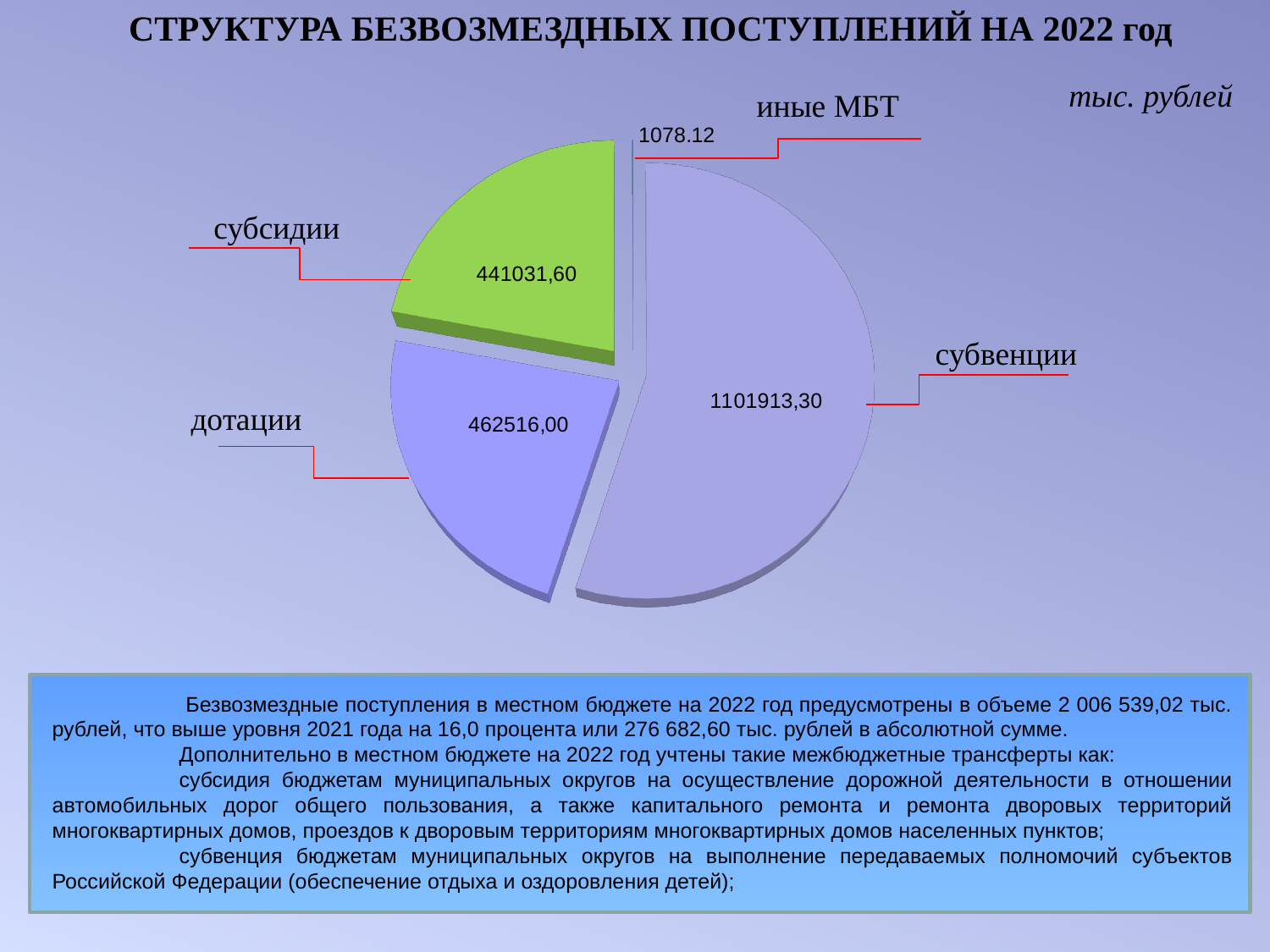
What is the value for субвенции in the pie chart? 1101913,30 How many categories are shown in the pie chart? 4 What is the difference between the values for субвенции and дотации? 639397,30 What is the difference between the values for дотации and субсидии? 21484,40 Which category has the largest slice in the pie chart? субвенции Which category has the smallest slice in the pie chart? иные МБТ What is the value for дотации in the pie chart? 462516,00 What is the value for субсидии in the pie chart? 441031,60 Which is larger, the value for дотации or the value for субсидии? дотации What unit of measurement is indicated for the chart values? тыс. рублей What is the value for иные МБТ in the pie chart? 1078.12 What type of chart is shown on the slide? pie chart